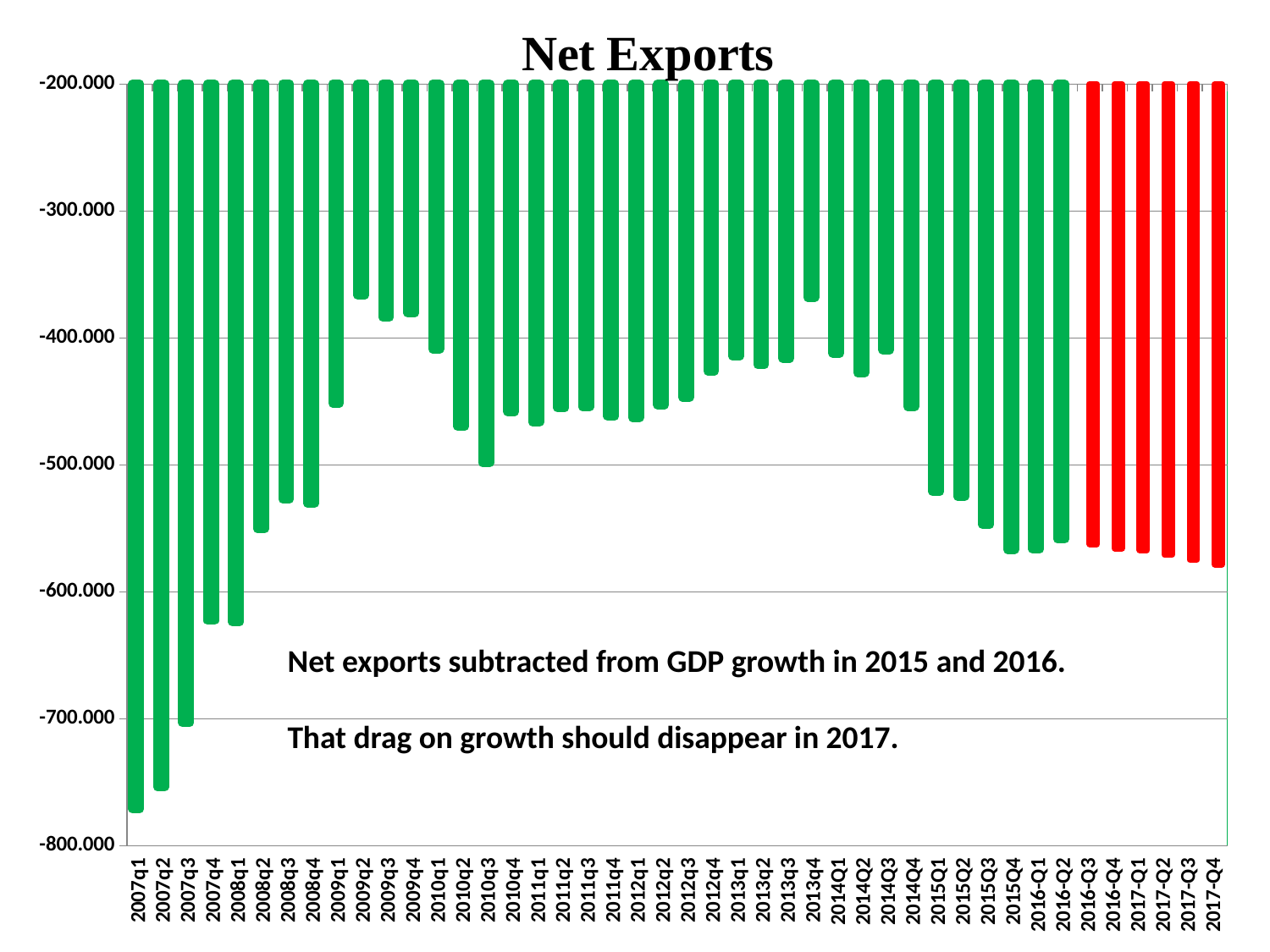
Is the value for 2015Q1 greater or less than -500.000? less From 2013q4 to 2017-Q4, do the net exports values rise or fall? fall What is the title of the chart? Net Exports What colour are the bars for the 2017 quarters? red Which has the larger (less negative) value, 2007q1 or 2017-Q4? 2017-Q4 How many quarters (bars) are plotted in the chart? 44 Is the value for 2017-Q4 greater or less than -600.000? greater Which quarter has the lowest (most negative) net exports value? 2007q1 Is the value for 2008q1 greater or less than -600.000? less What kind of chart is shown on the slide? bar chart Which has the larger (less negative) value, 2009q2 or 2010q3? 2009q2